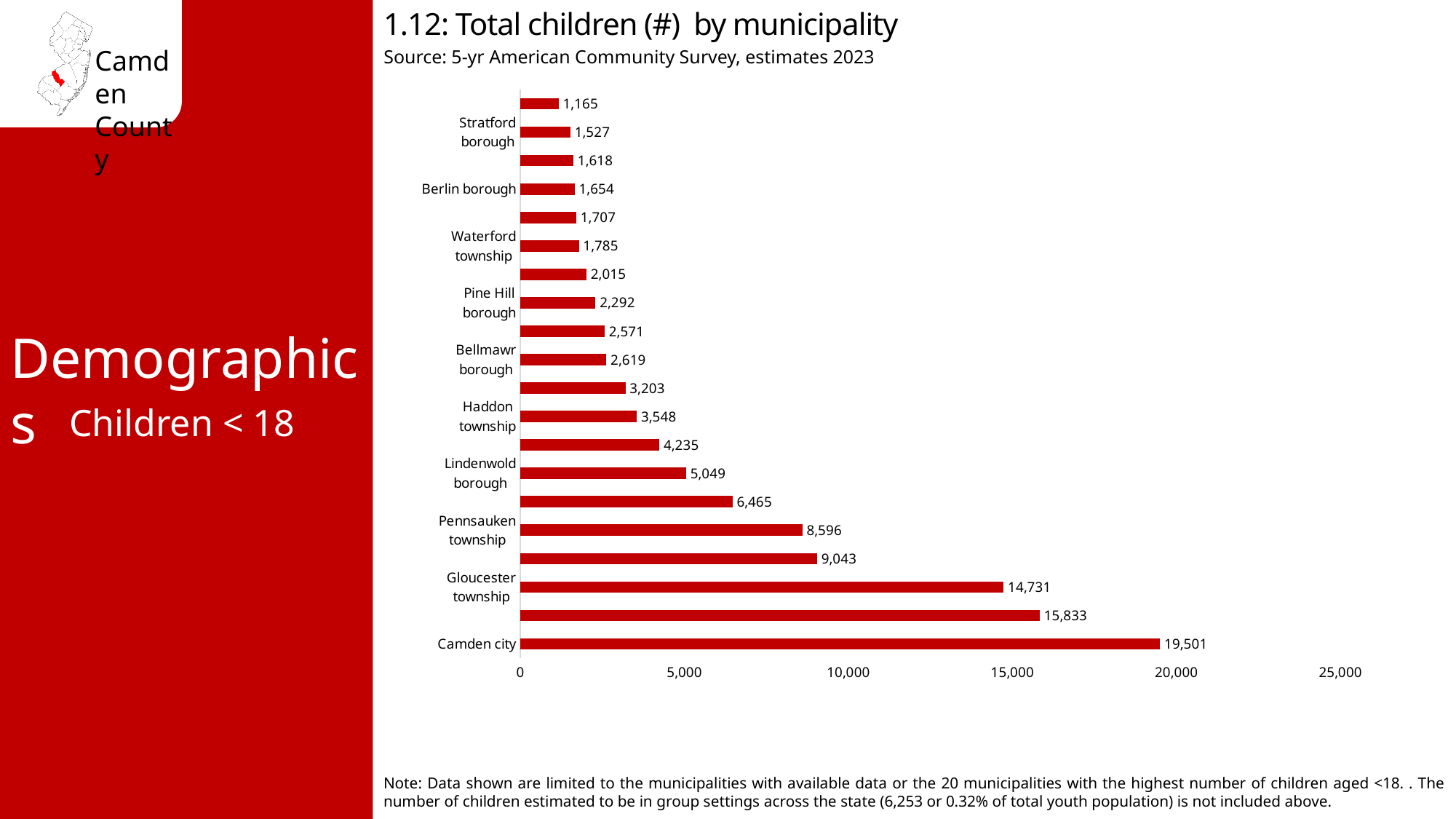
Which has more children, Pennsauken township or Lindenwold borough? Pennsauken township What is the total number of children for Haddon township? 3,548 What is the source cited for the chart data? 5-yr American Community Survey, estimates 2023 What is the difference in the number of children between Camden city and Gloucester township? 4,770 Which municipality has the highest number of children? Camden city How many bars are plotted in the chart? 20 What is the total number of children for Camden city? 19,501 Is the value for Bellmawr borough greater or less than 5,000? less What is the total number of children for Gloucester township? 14,731 What is the total number of children for Pennsauken township? 8,596 What is the total number of children for Lindenwold borough? 5,049 What kind of chart is shown on the slide? Bar chart